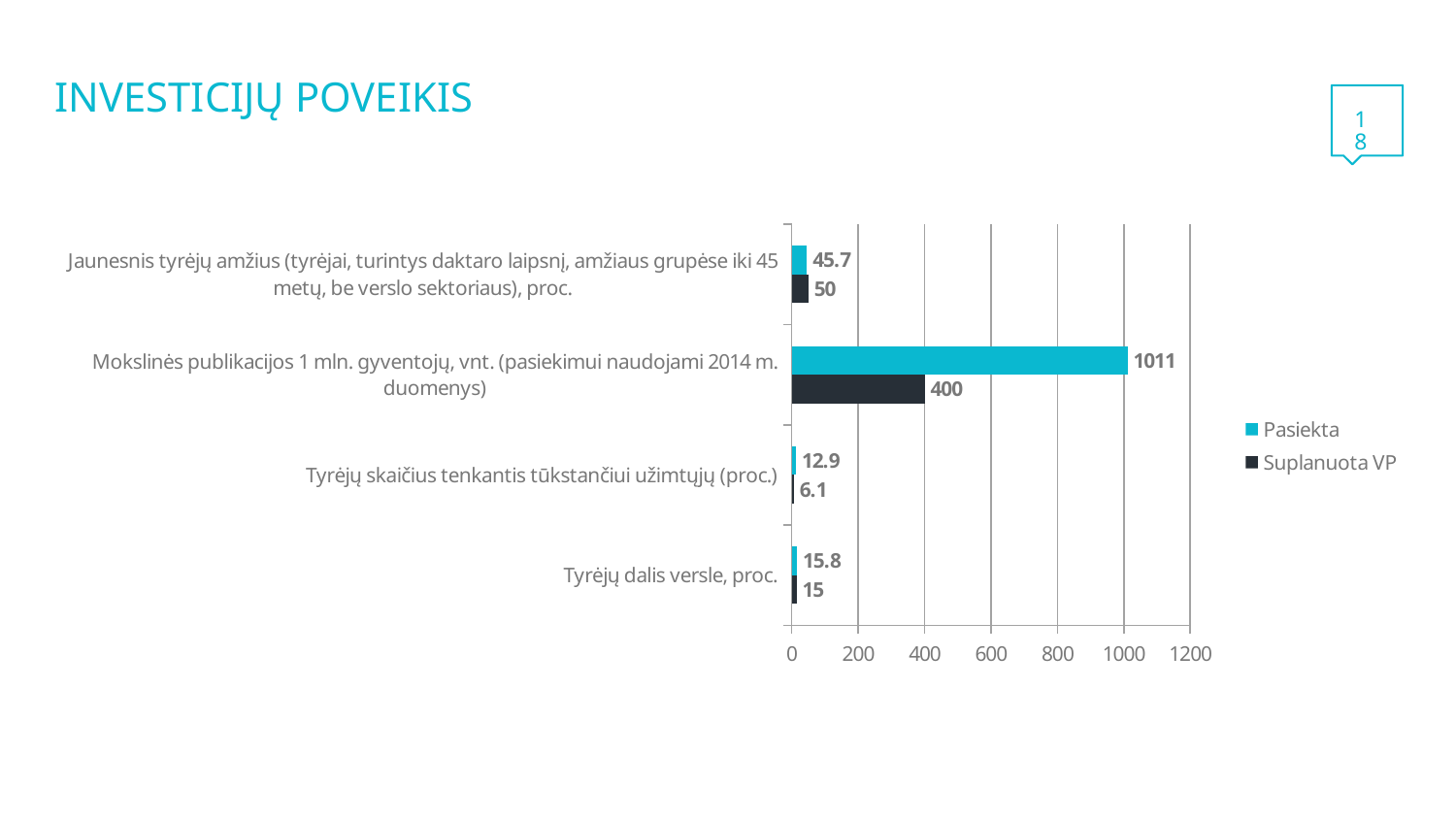
What is the Pasiekta value for 'Mokslinės publikacijos 1 mln. gyventojų, vnt.'? 1011 Which category has the highest Pasiekta value? Mokslinės publikacijos 1 mln. gyventojų, vnt. For 'Jaunesnis tyrėjų amžius', which is larger: Pasiekta or Suplanuota VP? Suplanuota VP What kind of chart is shown on the slide? Bar chart How many categories are shown on the chart? 4 What is the Pasiekta value for 'Tyrėjų skaičius tenkantis tūkstančiui užimtųjų (proc.)'? 12.9 What is the Suplanuota VP value for 'Jaunesnis tyrėjų amžius'? 50 What is the Pasiekta value for 'Tyrėjų dalis versle, proc.'? 15.8 What is the difference between the Pasiekta and Suplanuota VP values for 'Mokslinės publikacijos 1 mln. gyventojų, vnt.'? 611 What is the Suplanuota VP value for 'Mokslinės publikacijos 1 mln. gyventojų, vnt.'? 400 How many series does the legend list? 2 Which category has the lowest Suplanuota VP value? Tyrėjų skaičius tenkantis tūkstančiui užimtųjų (proc.)